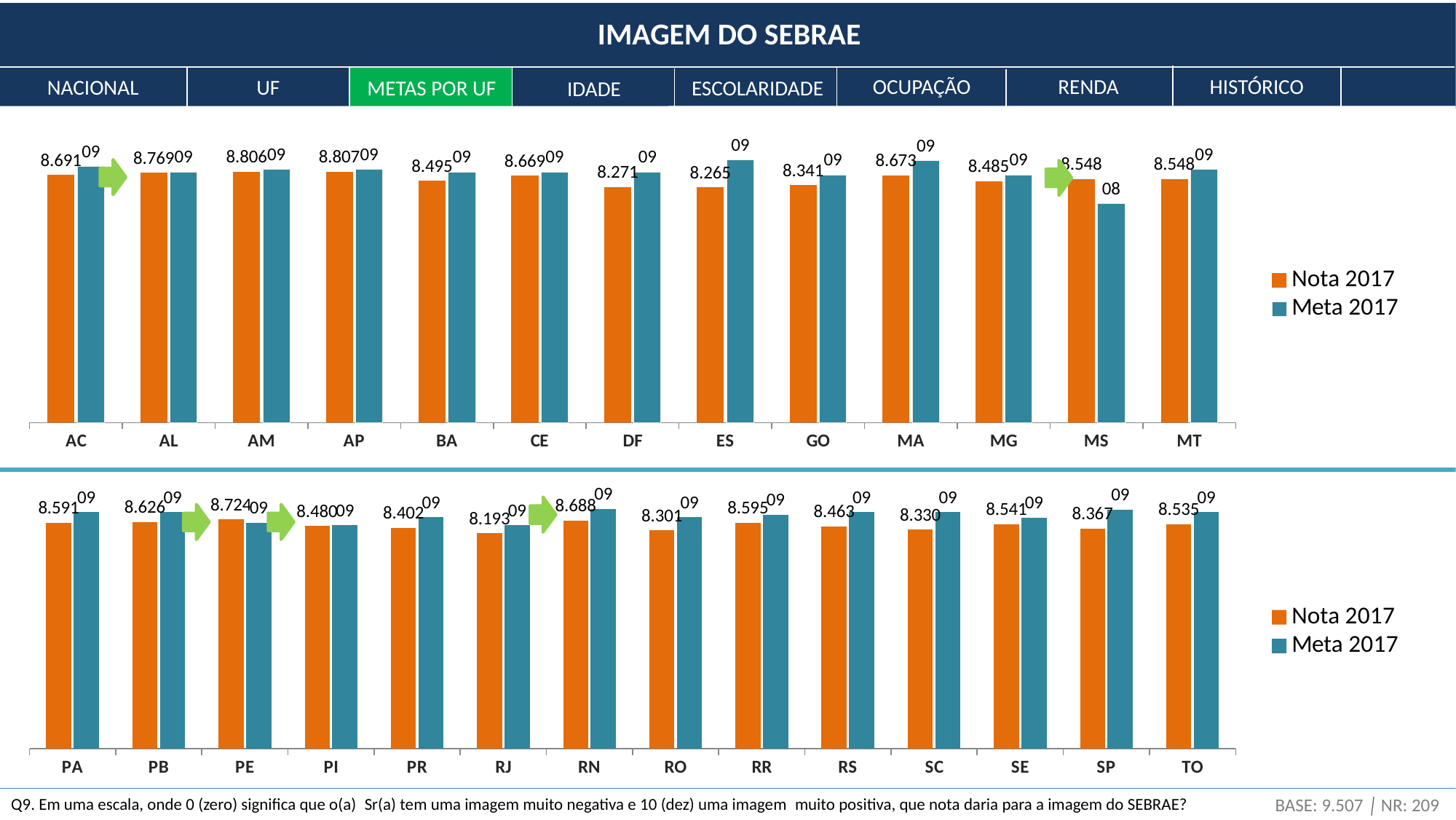
In the top chart, which state has the larger Nota 2017 value, AM or DF? AM In the bottom chart, which state has the lowest Nota 2017 value? RJ In the bottom chart, which state has the highest Nota 2017 value? PE In the top chart, which is larger for MS: the Nota 2017 value or the Meta 2017 value? Nota 2017 How many states are shown on the x axis of the bottom chart? 14 In the top chart, what is the Meta 2017 value for MS? 08 In the top chart, what is the Nota 2017 value for AC? 8.691 How many states are shown on the x axis of the top chart? 13 In the bottom chart, what is the difference between the Nota 2017 values for PE and RJ? 0.531 What type of chart is the top chart? Bar chart In the bottom chart, what is the Nota 2017 value for RJ? 8.193 How many series does the legend of the bottom chart list? 2